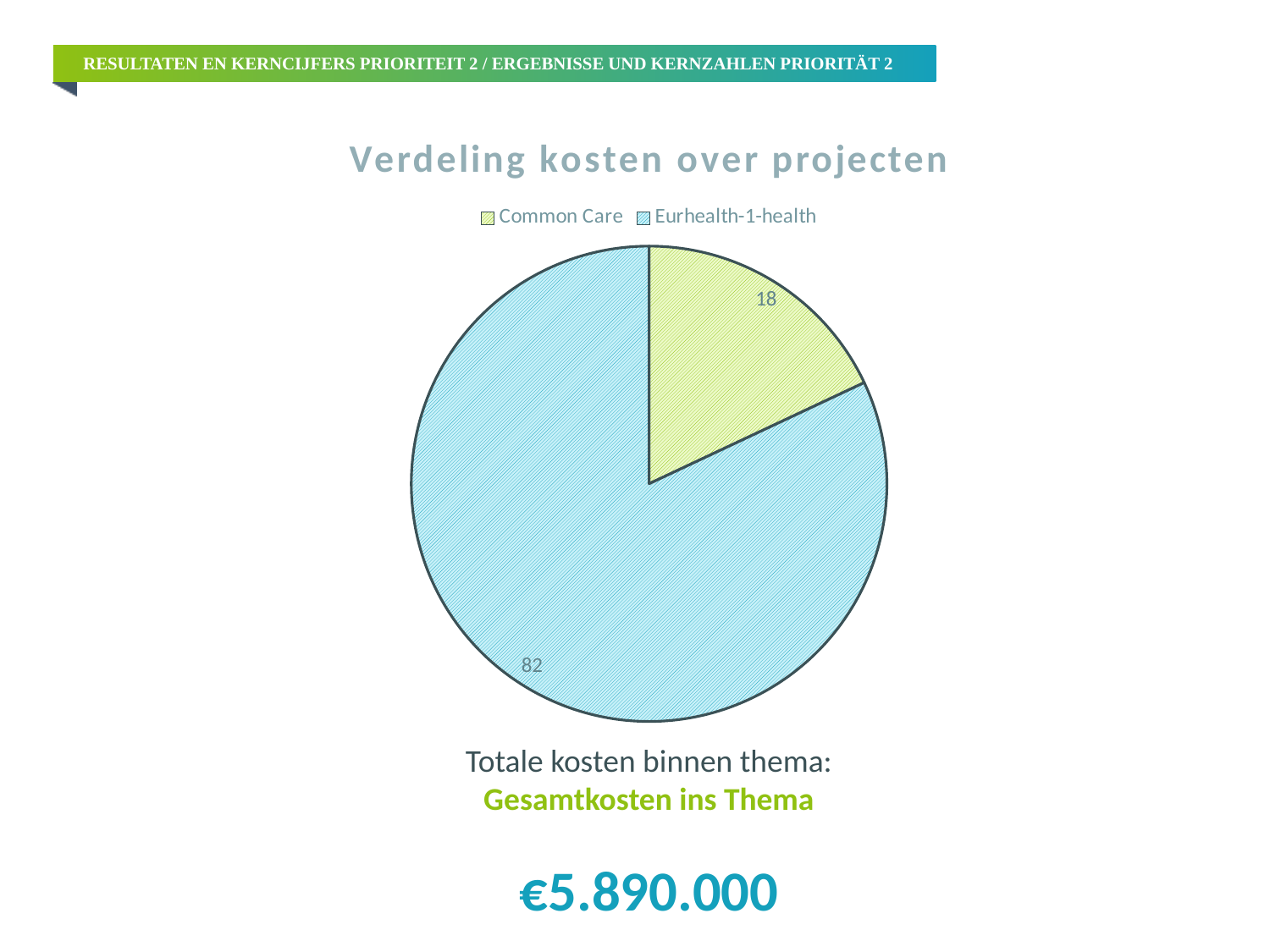
What is the title of the chart? Verdeling kosten over projecten What is the value shown for Common Care? 18 How many entries does the legend list? 2 What share of the pie does Common Care represent? 18% Which slice is the largest? Eurhealth-1-health What is the value shown for Eurhealth-1-health? 82 What is the difference between the values for Eurhealth-1-health and Common Care? 64 What kind of chart is shown on the slide? pie chart Which legend entry is shown in light green? Common Care Which is larger, the value for Common Care or the value for Eurhealth-1-health? Eurhealth-1-health Which slice is the smallest? Common Care How many slices does the pie chart have? 2